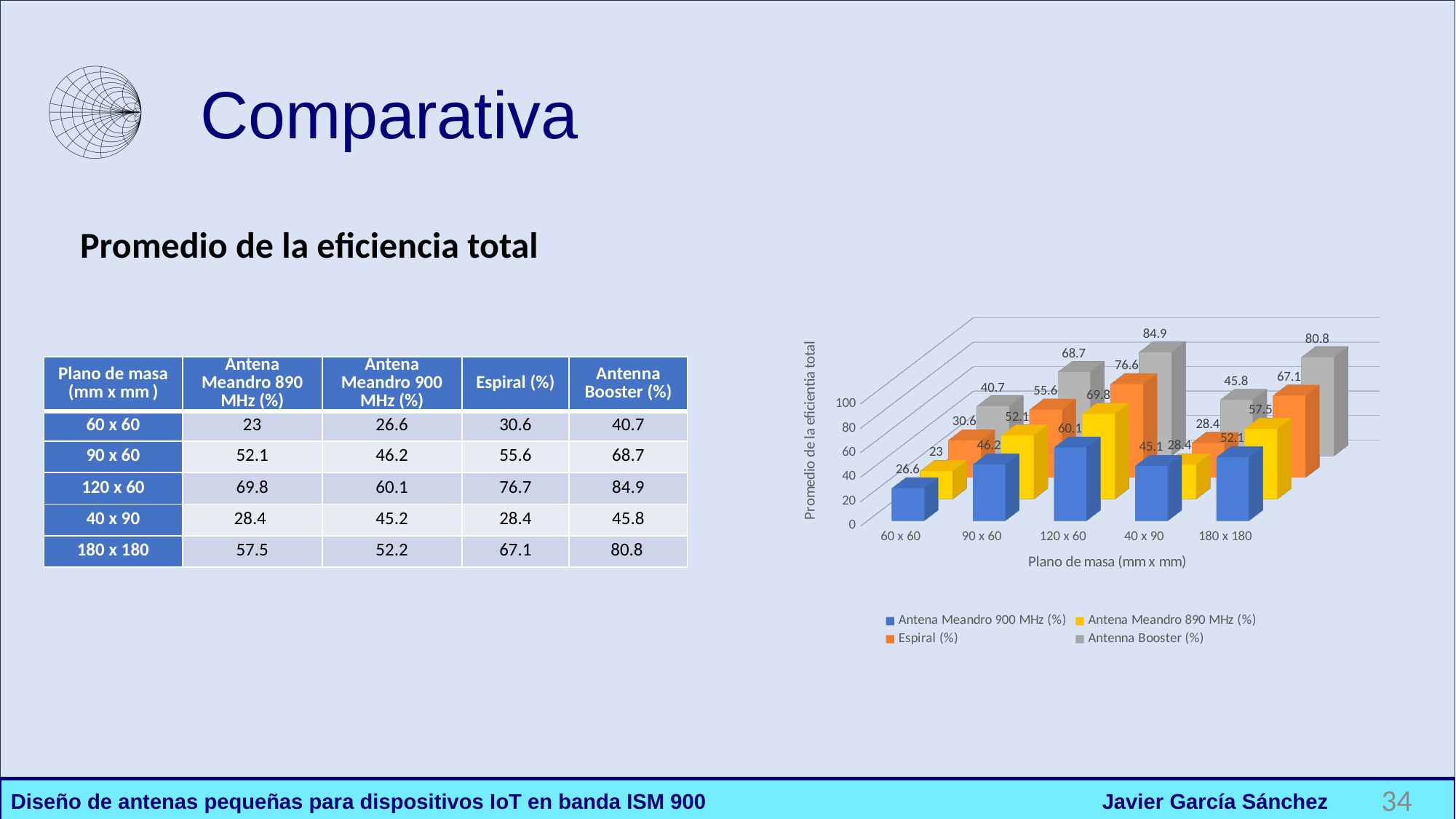
What is the title of the chart's vertical axis? Promedio de la eficientia total How many series does the chart legend list? 4 In the chart, at which ground plane size is the Antenna Booster (%) value highest? 120 x 60 What kind of chart is shown on the slide? bar chart In the chart, at which ground plane size is the Antena Meandro 890 MHz (%) value lowest? 60 x 60 In the chart, what is the value for Antena Meandro 890 MHz (%) at 40 x 90? 28.4 In the chart, what is the value for Espiral (%) at 60 x 60? 30.6 In the chart, what is the value for Antenna Booster (%) at 120 x 60? 84.9 In the chart, at 90 x 60, which is larger: Espiral (%) or Antena Meandro 890 MHz (%)? Espiral (%) In the chart, what is the value for Antenna Booster (%) at 90 x 60? 68.7 How many ground plane (Plano de masa) categories are shown on the x axis of the chart? 5 In the chart, what is the difference between the Antenna Booster (%) values at 180 x 180 and 60 x 60? 40.1